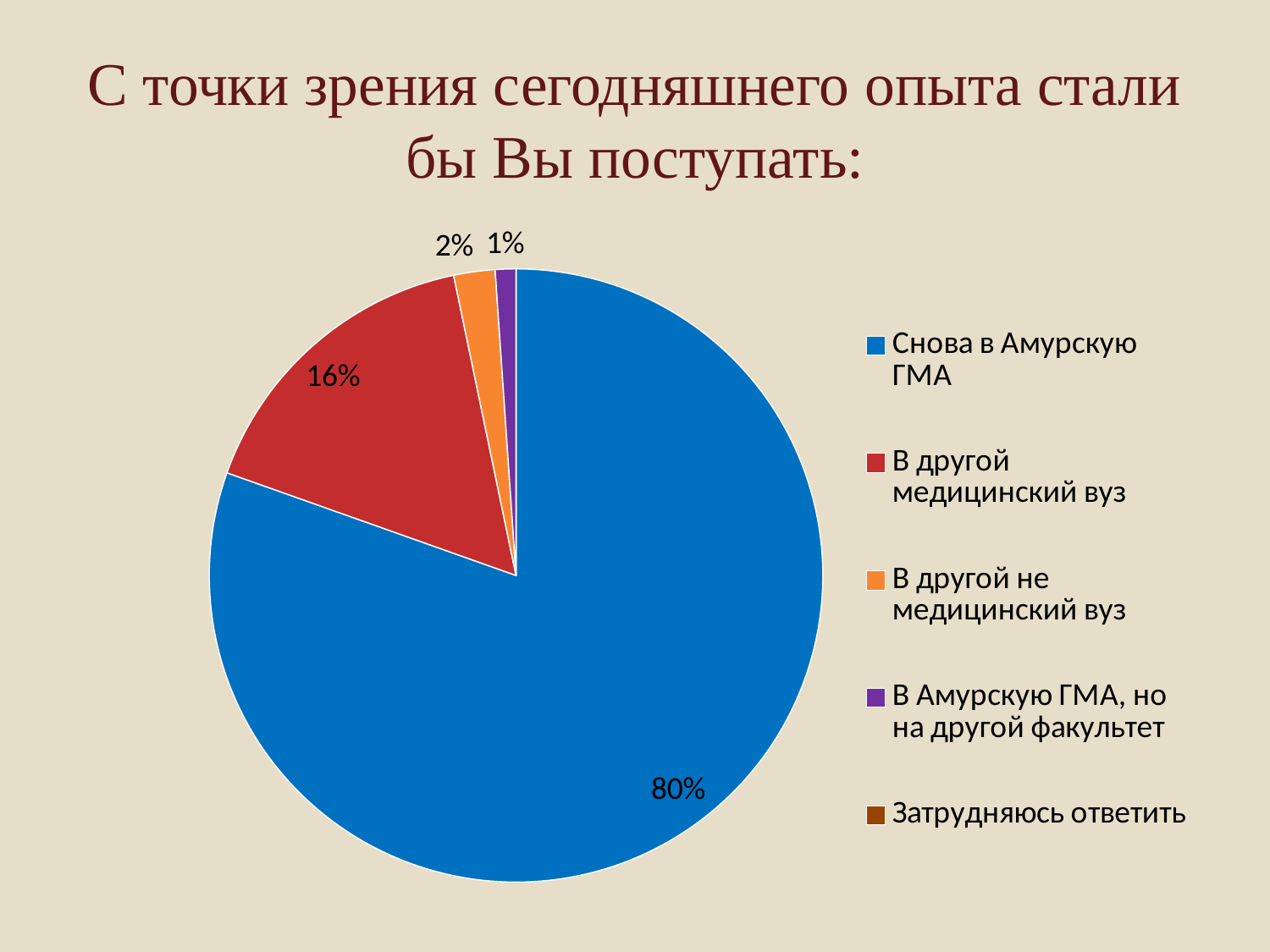
What is the difference in percentage points between "Снова в Амурскую ГМА" and "В другой медицинский вуз"? 64 percentage points How many entries does the legend list? 5 What percentage is shown for "В Амурскую ГМА, но на другой факультет"? 1% What kind of chart is shown on the slide? Pie chart What percentage is shown for "В другой не медицинский вуз"? 2% Which category has the largest slice of the pie? Снова в Амурскую ГМА Which is larger: the share for "В другой медицинский вуз" or for "В другой не медицинский вуз"? В другой медицинский вуз What percentage of respondents chose "Снова в Амурскую ГМА"? 80% What colour is the slice for "В другой медицинский вуз"? Red Which of the slices with a printed percentage label is the smallest? В Амурскую ГМА, но на другой факультет What percentage is shown for "В другой медицинский вуз"? 16% What share of the pie does "Снова в Амурскую ГМА" take? 80%